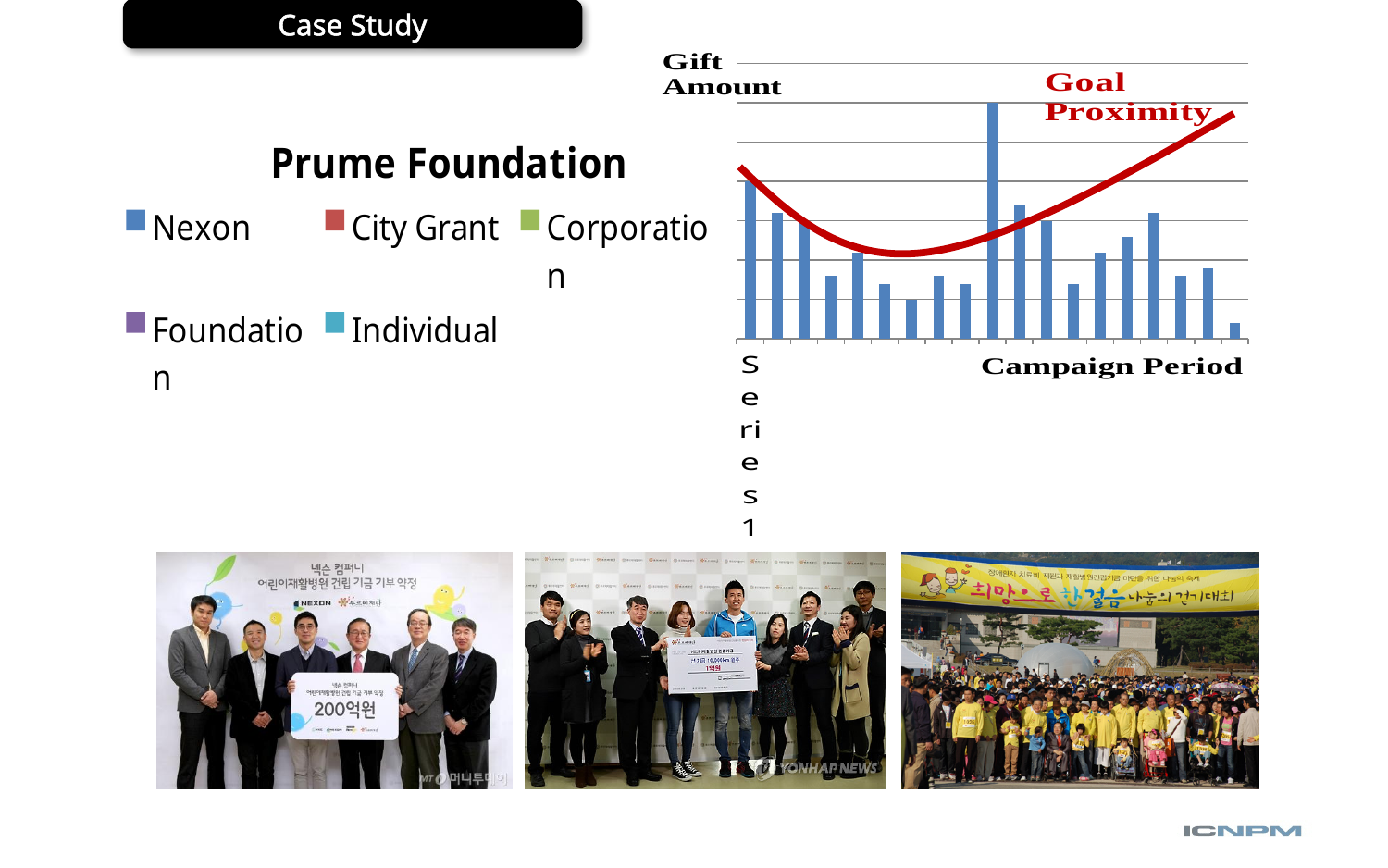
What is the label on the horizontal axis of the bar chart? Campaign Period Is the first bar on the left taller or shorter than the last bar on the right? taller What is the label on the vertical axis of the bar chart? Gift Amount Counting from the left, which bar in the bar chart is the tallest? the 10th bar How many entries does the legend on the left of the slide list? 5 Which bar in the bar chart is the shortest? the last bar on the right What kind of chart is shown on the slide? bar chart Is the tallest bar in the bar chart taller or shorter than the first bar on the left? taller Does the red Goal Proximity curve fall or rise toward the right end of the campaign period? rise How many bars are plotted in the bar chart? 19